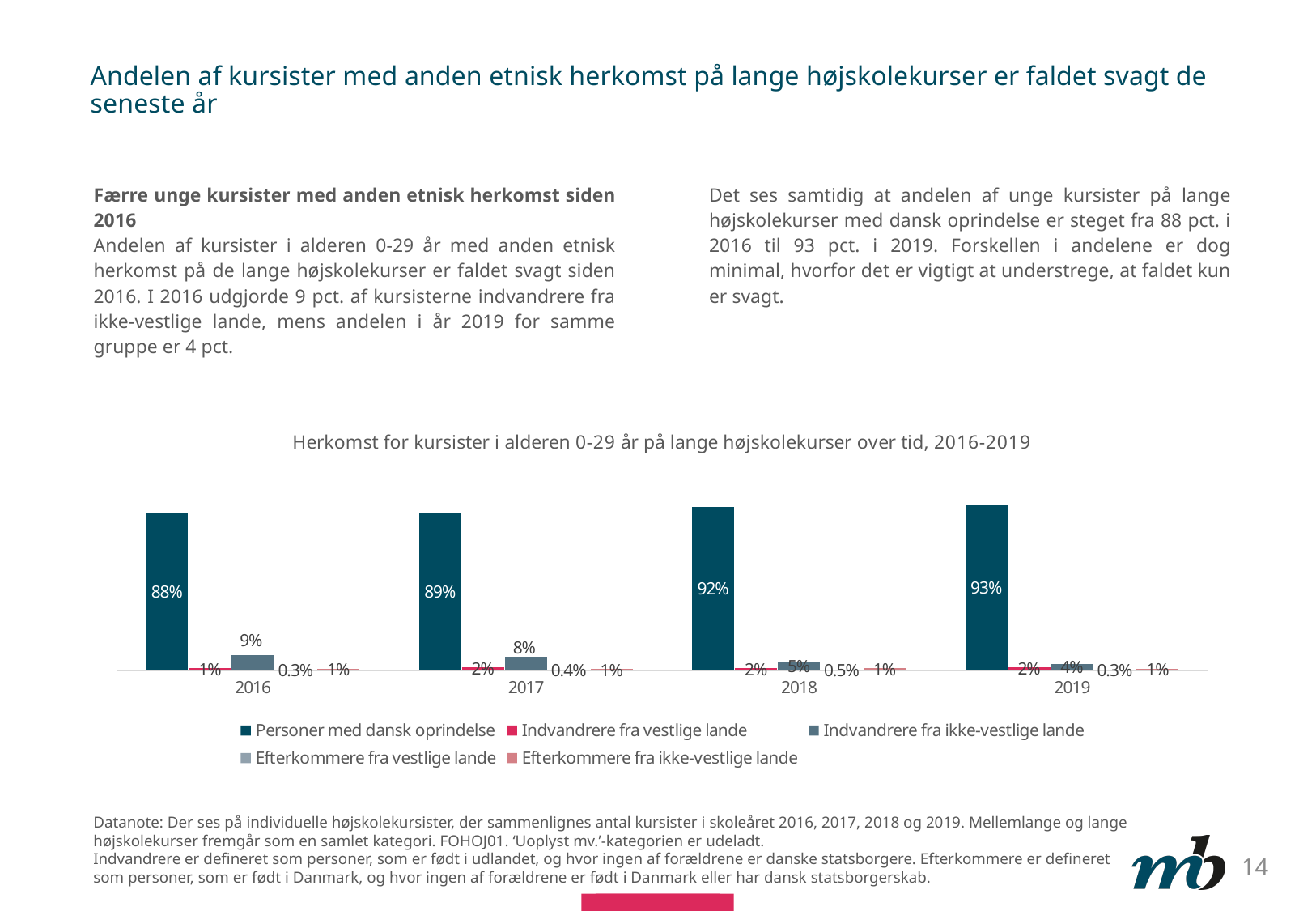
What is the difference between the 'Indvandrere fra ikke-vestlige lande' values in 2016 and 2019? 5 percentage points How many series does the legend list? 5 Does the value for 'Personer med dansk oprindelse' rise or fall from 2016 to 2019? rise What is the value for 'Indvandrere fra vestlige lande' in 2017? 2% How many years are shown on the x axis? 4 What is the value for 'Personer med dansk oprindelse' in 2016? 88% What is the value for 'Indvandrere fra ikke-vestlige lande' in 2019? 4% In which year is the value for 'Personer med dansk oprindelse' highest? 2019 Which is larger: 'Indvandrere fra ikke-vestlige lande' in 2017 or in 2018? 2017 What kind of chart is shown on the slide? bar chart What is the value for 'Efterkommere fra vestlige lande' in 2018? 0.5% In which year is the value for 'Indvandrere fra ikke-vestlige lande' lowest? 2019